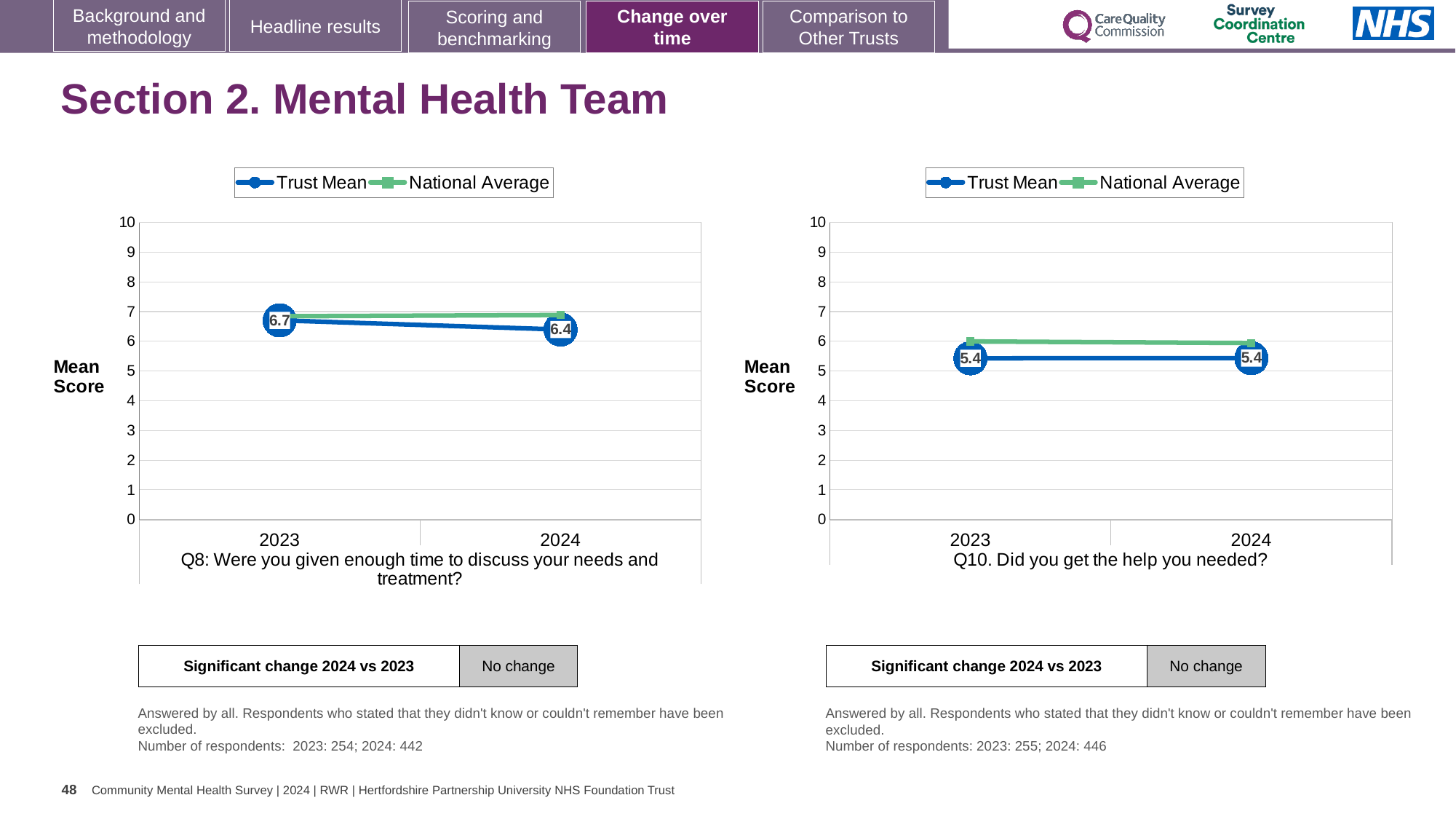
In the Q10 chart (right), does the Trust Mean rise, fall or stay the same from 2023 to 2024? stay the same What kind of chart is the Q10 chart (right)? line chart In the Q10 chart (right), what is the Trust Mean for 2024? 5.4 In the Q8 chart (left), which is larger for 2024: the Trust Mean or the National Average? National Average In the Q8 chart (left), what is the Trust Mean for 2023? 6.7 In the Q8 chart (left), what is the Trust Mean for 2024? 6.4 In the Q8 chart (left), by how much did the Trust Mean change from 2023 to 2024? 0.3 In the Q8 chart (left), does the Trust Mean rise or fall from 2023 to 2024? fall In the Q10 chart (right), is the National Average for 2023 greater or less than 5? greater What is the label on the y axis of the Q8 chart (left)? Mean Score How many series does the legend of the Q8 chart (left) list? 2 How many years are shown on the x axis of the Q10 chart (right)? 2